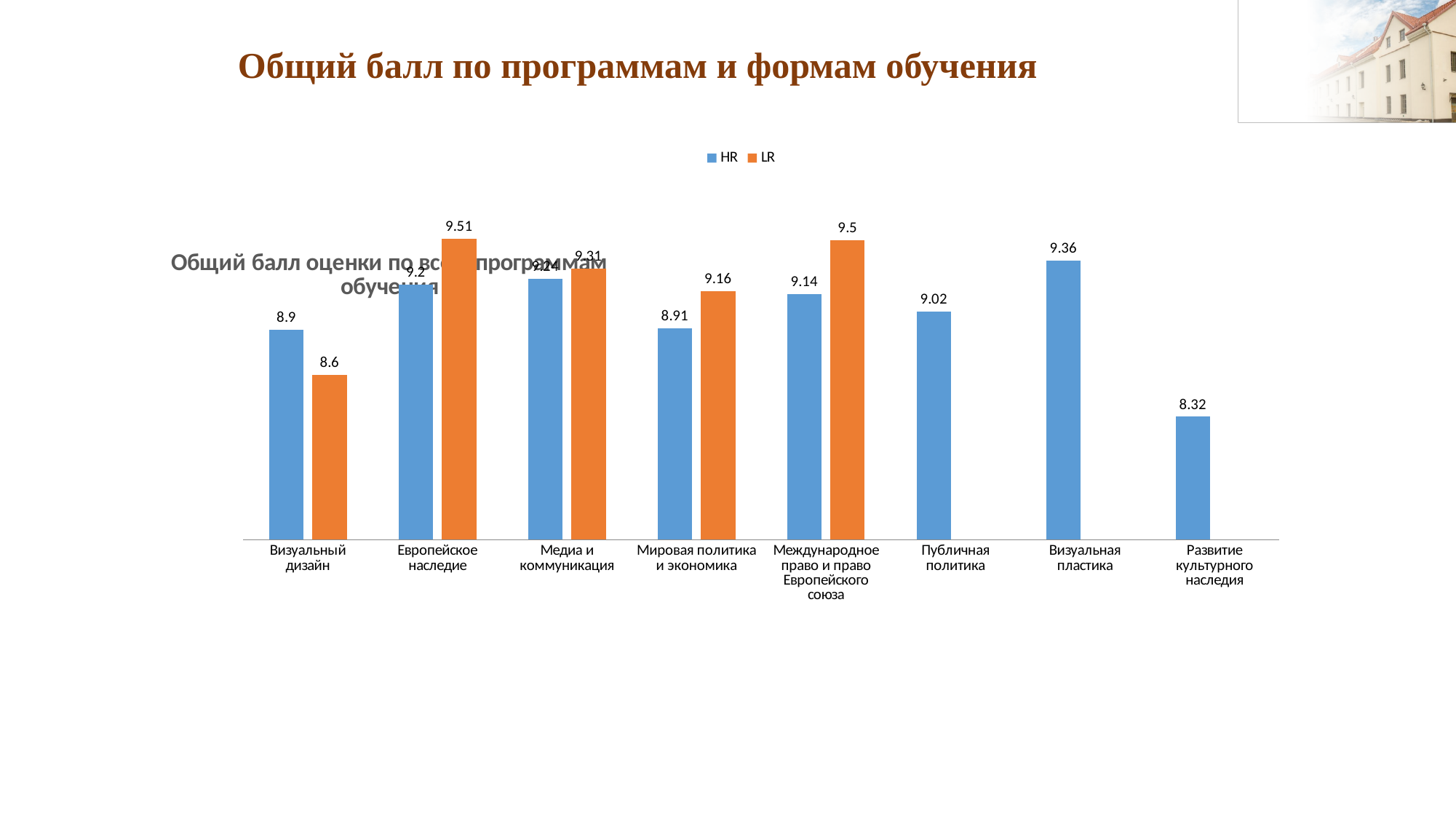
How many series does the legend list? 2 Which category has the lowest LR value? Визуальный дизайн What is the difference between the HR and LR values for Визуальный дизайн? 0.3 What is the HR value for Визуальный дизайн? 8.9 What is the LR value for Европейское наследие? 9.51 What is the HR value for Развитие культурного наследия? 8.32 What is the LR value for Мировая политика и экономика? 9.16 For Мировая политика и экономика, which is larger, HR or LR? LR Which category has the highest HR value? Визуальная пластика What is the LR value for Визуальный дизайн? 8.6 What is the HR value for Международное право и право Европейского союза? 9.14 Which category has the lowest HR value? Развитие культурного наследия